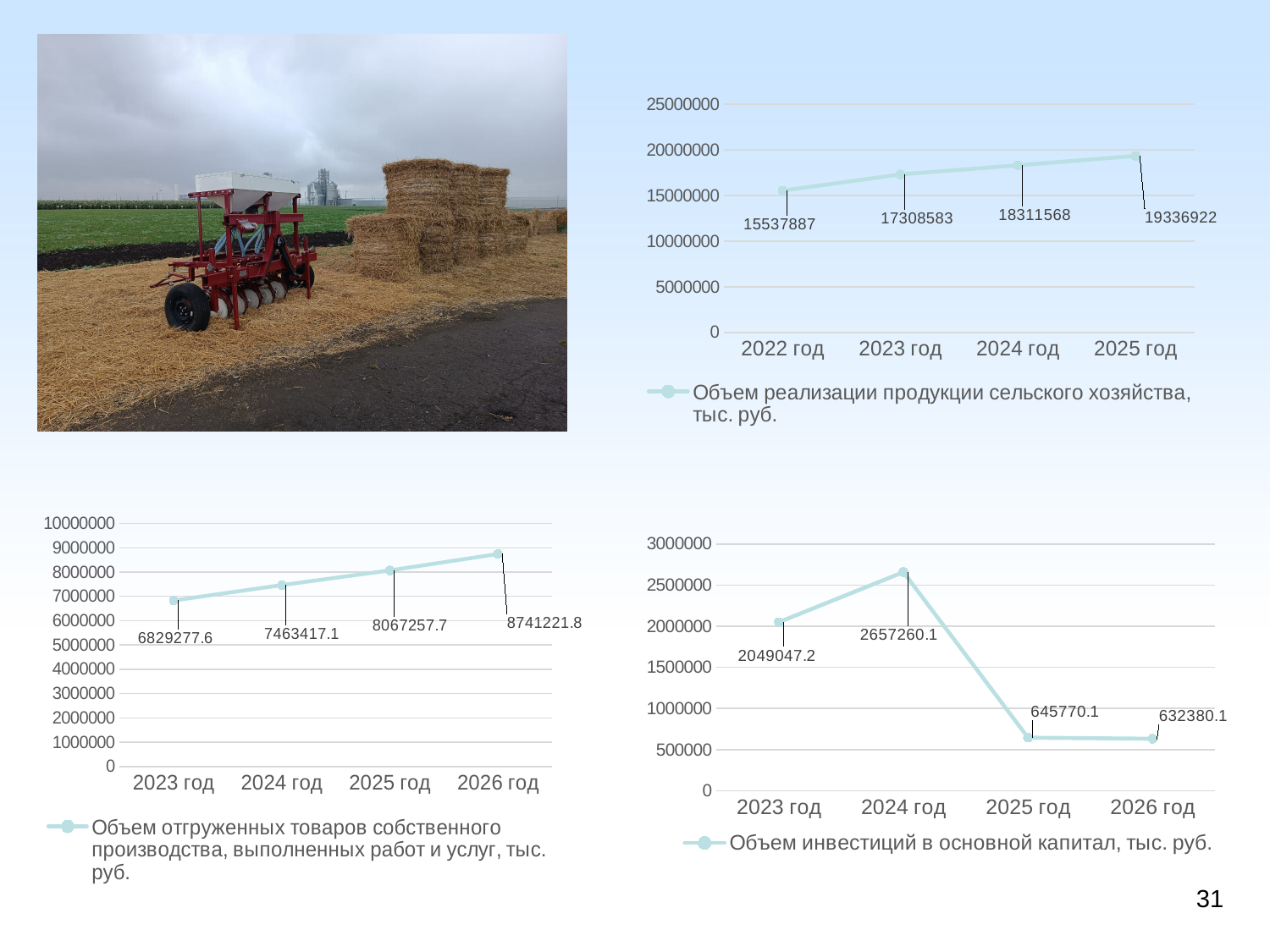
In the top-right chart, what is the value for 2025 год? 19336922 In the bottom-left chart, what is the difference between the values for 2026 год and 2023 год? 1911944.2 In the top-right chart, what is the value for 2022 год? 15537887 In the top-right chart, what is the difference between the values for 2025 год and 2022 год? 3799035 In the bottom-right chart, what is the value for 2024 год? 2657260.1 In the bottom-right chart, which is larger, the value for 2023 год or the value for 2025 год? 2023 год In the bottom-left chart, what is the value for 2024 год? 7463417.1 What kind of chart is the top-right chart? line chart In the top-right chart, do the values rise or fall from 2022 год to 2025 год? rise In the bottom-right chart, which year has the lowest value? 2026 год How many data points are plotted in the bottom-right chart? 4 In the bottom-left chart, which year has the highest value? 2026 год